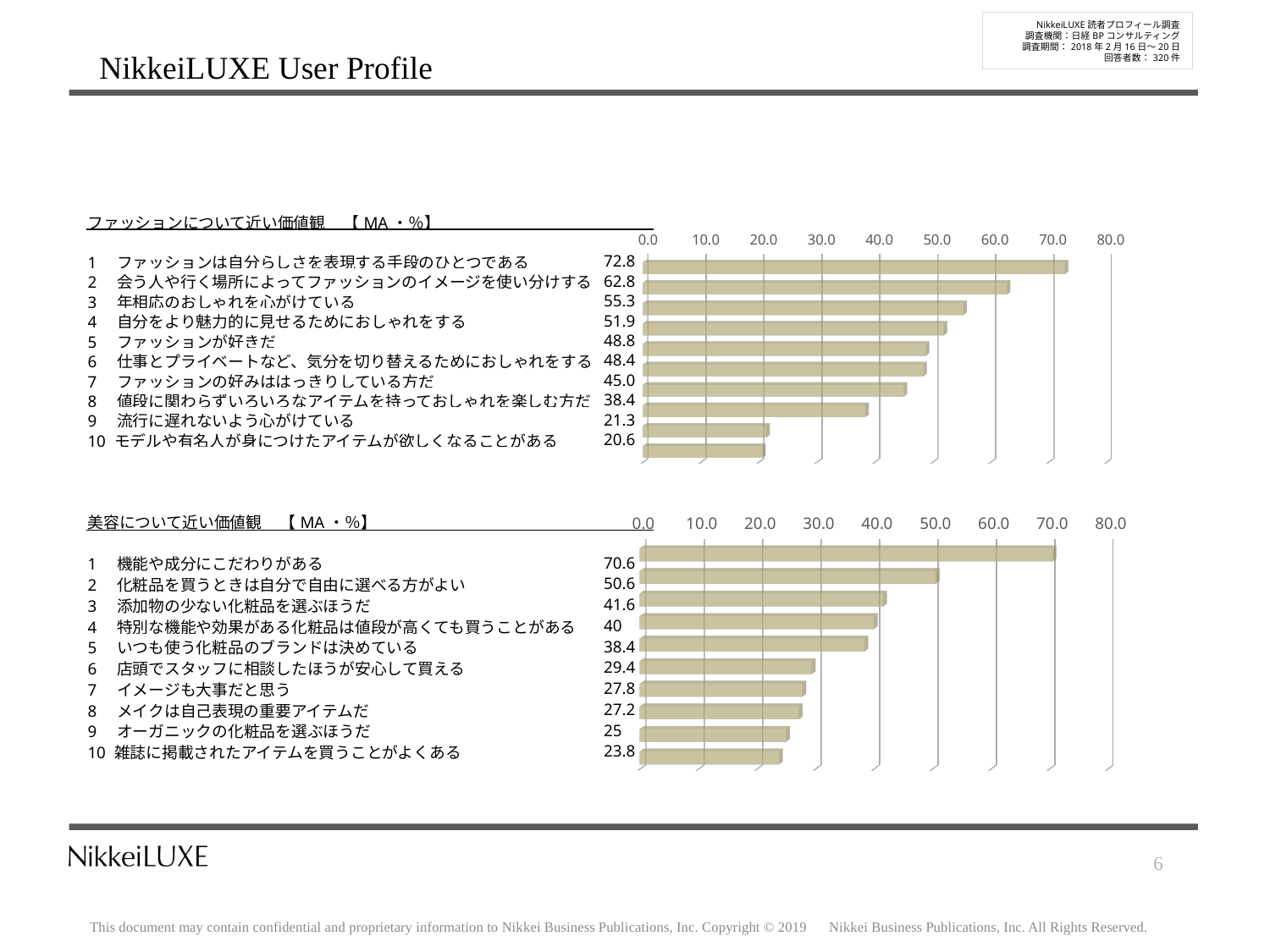
In the bottom chart (美容について近い価値観), which item has the highest value? 機能や成分にこだわりがある In the top chart (ファッションについて近い価値観), is the value for 「ファッションの好みははっきりしている方だ」 greater or less than 40.0? greater In the top chart (ファッションについて近い価値観), what is the value for 「流行に遅れないよう心がけている」? 21.3 In the top chart (ファッションについて近い価値観), what is the value for 「ファッションは自分らしさを表現する手段のひとつである」? 72.8 In the bottom chart (美容について近い価値観), what is the value for 「機能や成分にこだわりがある」? 70.6 In the bottom chart (美容について近い価値観), what is the value for 「オーガニックの化粧品を選ぶほうだ」? 25 In the top chart (ファッションについて近い価値観), how many items are plotted? 10 In the top chart (ファッションについて近い価値観), which item has the lowest value? モデルや有名人が身につけたアイテムが欲しくなることがある In the top chart (ファッションについて近い価値観), what is the difference between 「ファッションは自分らしさを表現する手段のひとつである」 and 「会う人や行く場所によってファッションのイメージを使い分けする」? 10.0 What type of chart is used in the bottom chart (美容について近い価値観)? Bar chart In the bottom chart (美容について近い価値観), what is the difference between 「化粧品を買うときは自分で自由に選べる方がよい」 and 「雑誌に掲載されたアイテムを買うことがよくある」? 26.8 In the bottom chart (美容について近い価値観), which is larger: 「添加物の少ない化粧品を選ぶほうだ」 or 「店頭でスタッフに相談したほうが安心して買える」? 添加物の少ない化粧品を選ぶほうだ